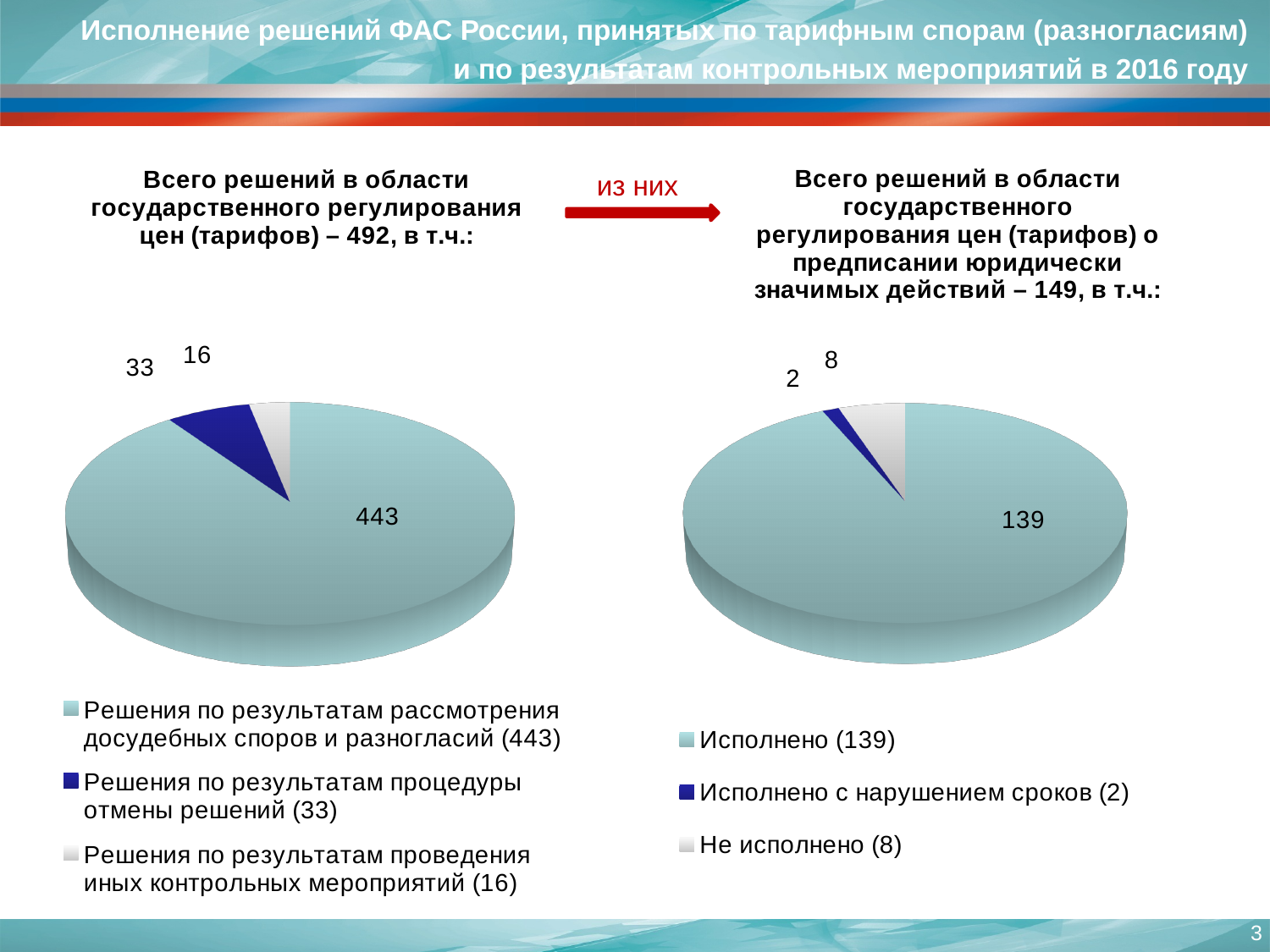
In the right pie chart, what is the total of all slices? 149 In the right pie chart, what is the value for 'Не исполнено'? 8 In the right pie chart, which is larger: 'Не исполнено' or 'Исполнено с нарушением сроков'? Не исполнено In the left pie chart, what is the difference between the values for 'Решения по результатам процедуры отмены решений' and 'Решения по результатам проведения иных контрольных мероприятий'? 17 In the right pie chart, what is the difference between the values for 'Не исполнено' and 'Исполнено с нарушением сроков'? 6 In the left pie chart, which category has the smallest value? Решения по результатам проведения иных контрольных мероприятий What type of chart is used on the right side of the slide? Pie chart In the left pie chart, what is the value for 'Решения по результатам процедуры отмены решений'? 33 How many slices does the left pie chart have? 3 In the left pie chart, what is the value for 'Решения по результатам рассмотрения досудебных споров и разногласий'? 443 In the right pie chart, which category has the largest value? Исполнено In the right pie chart, what is the value for 'Исполнено с нарушением сроков'? 2